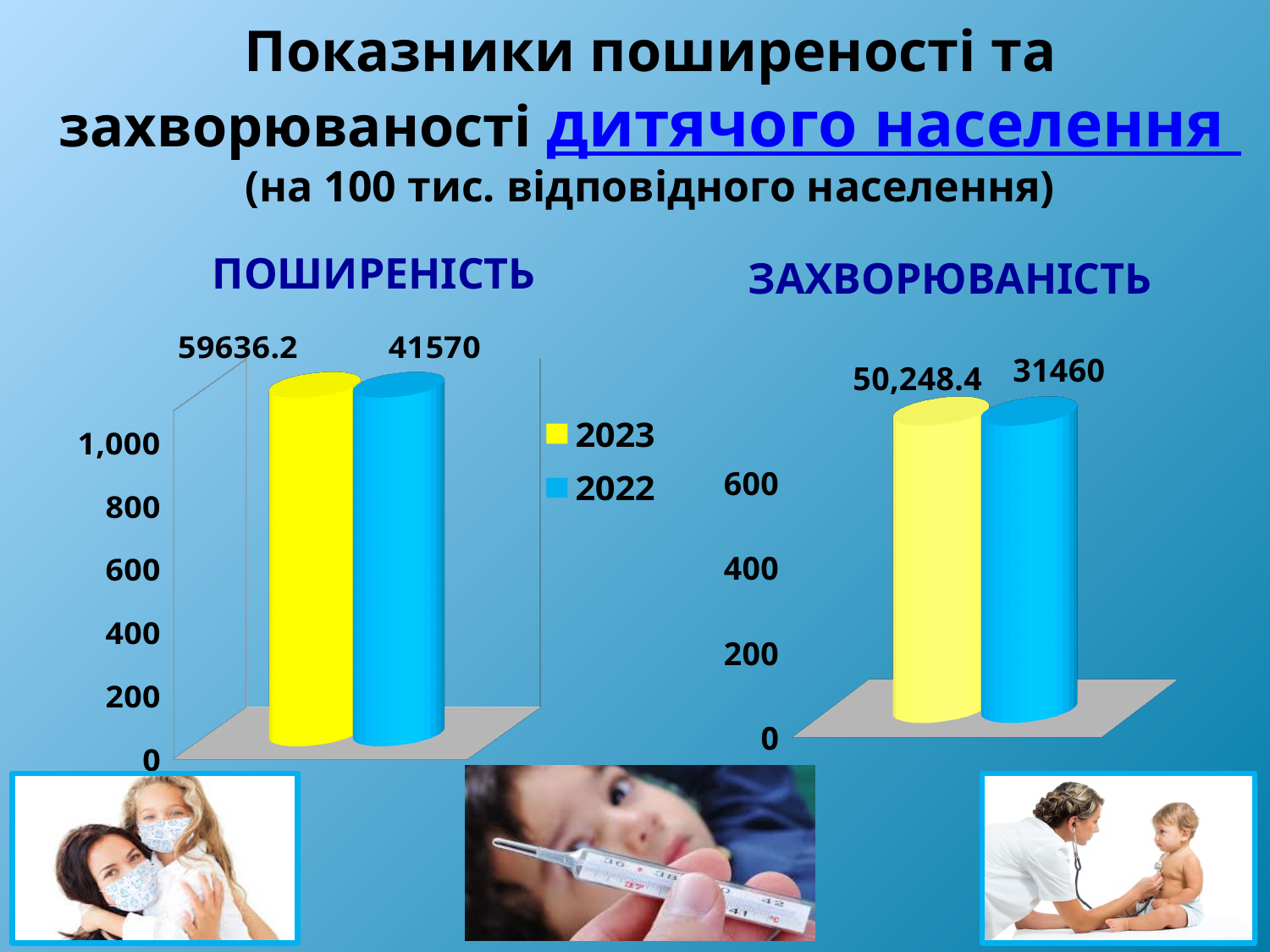
How many series does the legend on the slide list? 2 Which colour represents 2022 in the legend? blue In the ПОШИРЕНІСТЬ chart, which year has the higher value? 2023 How many bars are shown in the ЗАХВОРЮВАНІСТЬ chart? 2 What kind of chart is the ПОШИРЕНІСТЬ chart? bar chart In the ПОШИРЕНІСТЬ chart, what is the difference between the 2023 and 2022 values? 18066.2 In the ЗАХВОРЮВАНІСТЬ chart, what is the value for 2022? 31460 In the ЗАХВОРЮВАНІСТЬ chart, which year has the lower value? 2022 In the ПОШИРЕНІСТЬ chart, what is the value for 2023? 59636.2 In the ЗАХВОРЮВАНІСТЬ chart, what is the value for 2023? 50,248.4 In the ПОШИРЕНІСТЬ chart, what is the value for 2022? 41570 In the ЗАХВОРЮВАНІСТЬ chart, is the value for 2023 larger or smaller than the value for 2022? larger